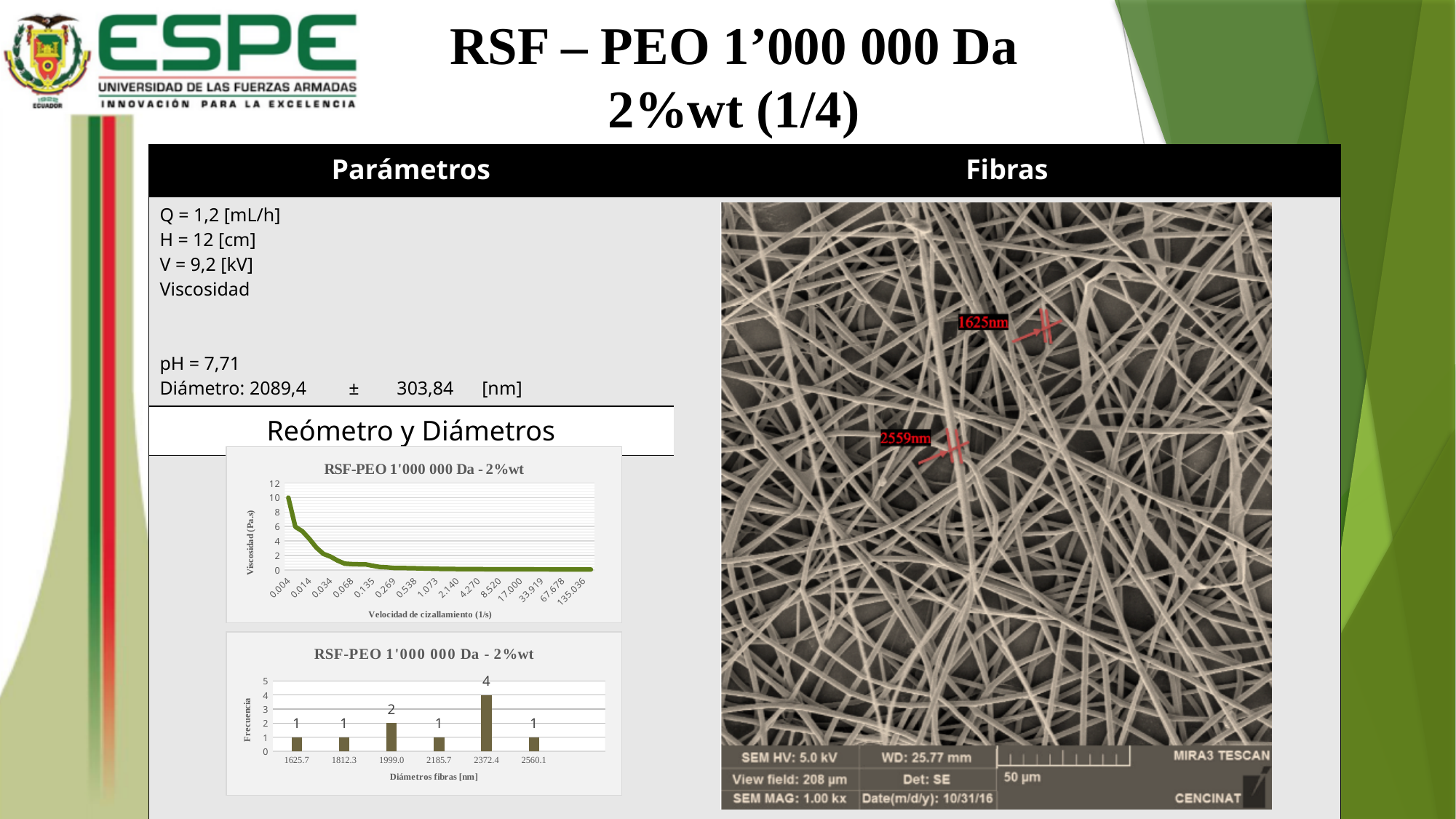
What kind of chart is the upper chart on the slide? line chart In the upper line chart, is the viscosity at a shear rate of 0.004 greater or less than 8? greater In the lower bar chart, which is larger: the frequency for 1999.0 or the frequency for 2185.7? 1999.0 In the lower bar chart, what is the difference between the frequency for 2372.4 and the frequency for 1999.0? 2 What kind of chart is the lower chart on the slide? bar chart In the lower bar chart, what is the frequency for the diameter 1999.0? 2 In the lower bar chart, which diameter category has the highest frequency? 2372.4 In the lower bar chart, what is the sum of all the frequencies shown? 10 In the lower bar chart, what is the frequency for the diameter 2372.4? 4 In the lower bar chart, how many diameter categories are shown on the x axis? 6 In the upper line chart, do the viscosity values rise or fall as the shear rate increases along the x axis? fall What is the x-axis label of the upper line chart? Velocidad de cizallamiento (1/s)